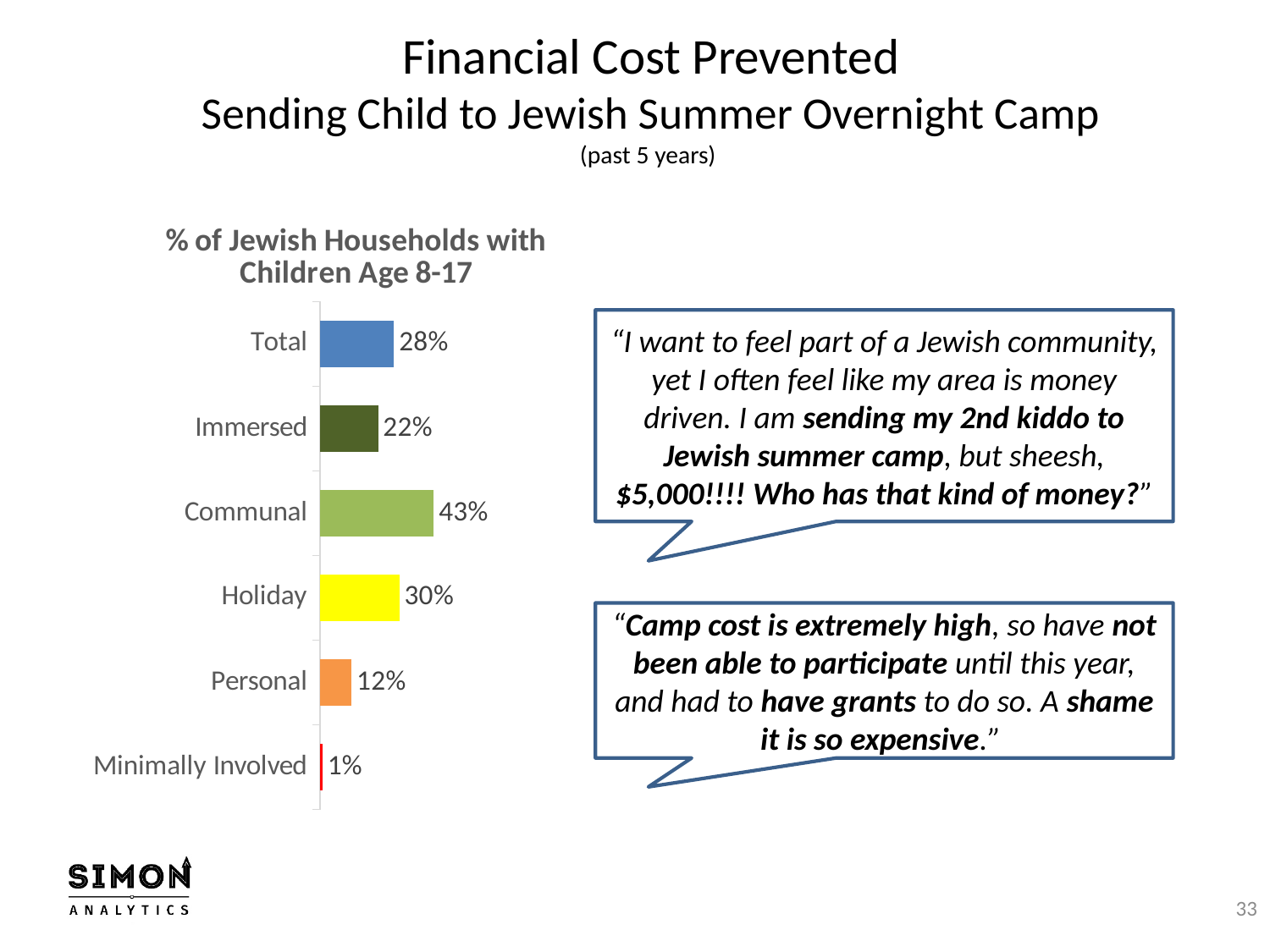
What is the value for Minimally Involved? 1% What is the difference between the values for Communal and Immersed? 21% How many categories are shown in the chart? 6 What is the value for Total? 28% Which category has the highest value? Communal What is the difference between the values for Holiday and Personal? 18% What kind of chart is shown on the slide? Bar chart Which category has the lowest value? Minimally Involved What is the title of the chart? % of Jewish Households with Children Age 8-17 Which is larger, the value for Immersed or the value for Holiday? Holiday What is the value for Holiday? 30% What is the value for Communal? 43%